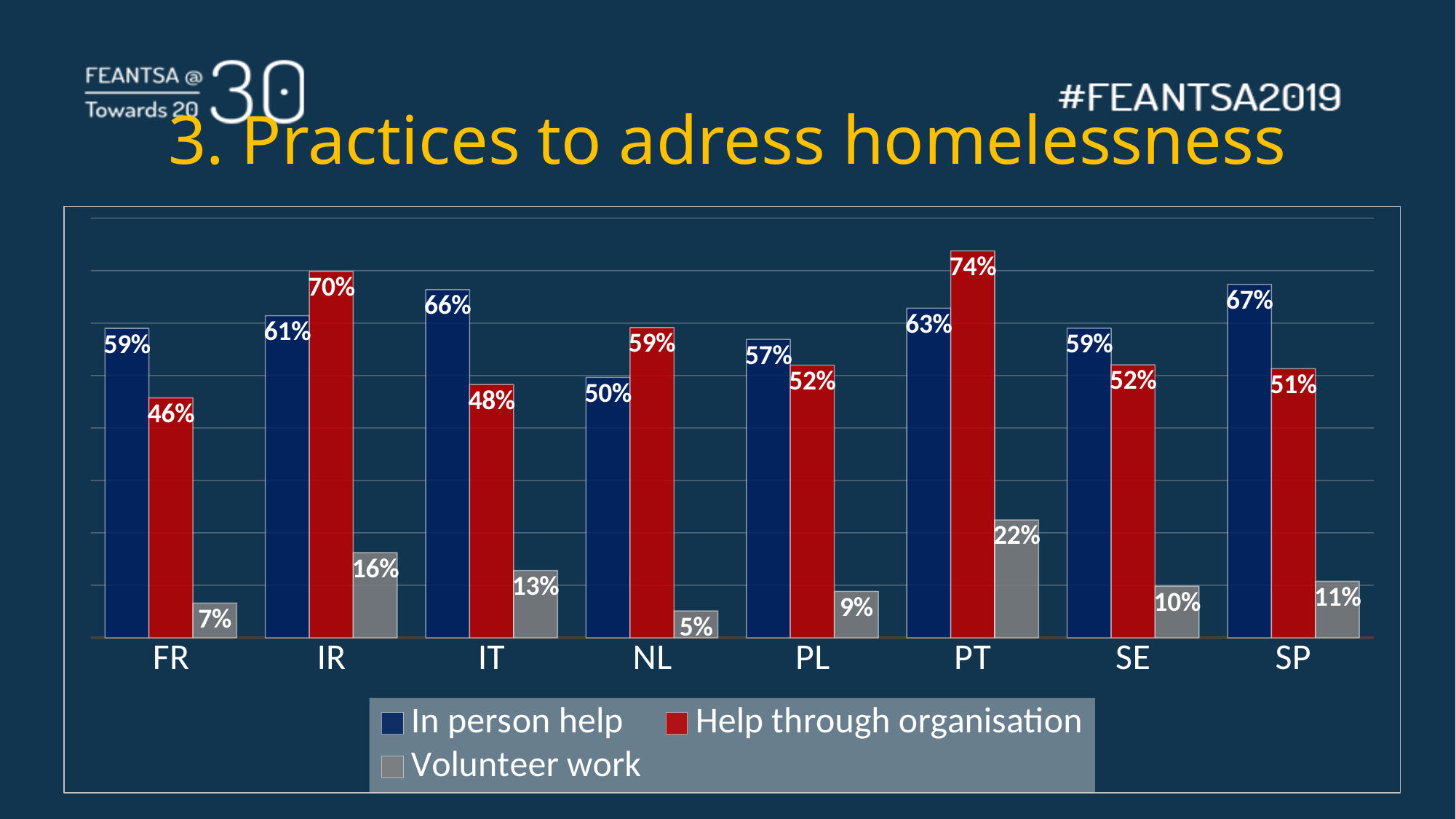
What kind of chart is shown on the slide? Bar chart How many countries are shown on the x axis? 8 Which country has the highest value for In person help? SP What is the value for Help through organisation in PT? 74% What is the value for In person help in IT? 66% Which is larger in FR: In person help or Help through organisation? In person help Which colour represents Volunteer work in the chart? Grey Which country has the lowest value for Volunteer work? NL What is the value for Volunteer work in NL? 5% What is the difference between Help through organisation and In person help in IR? 9% How many series does the legend list? 3 Which country has the highest value for Help through organisation? PT